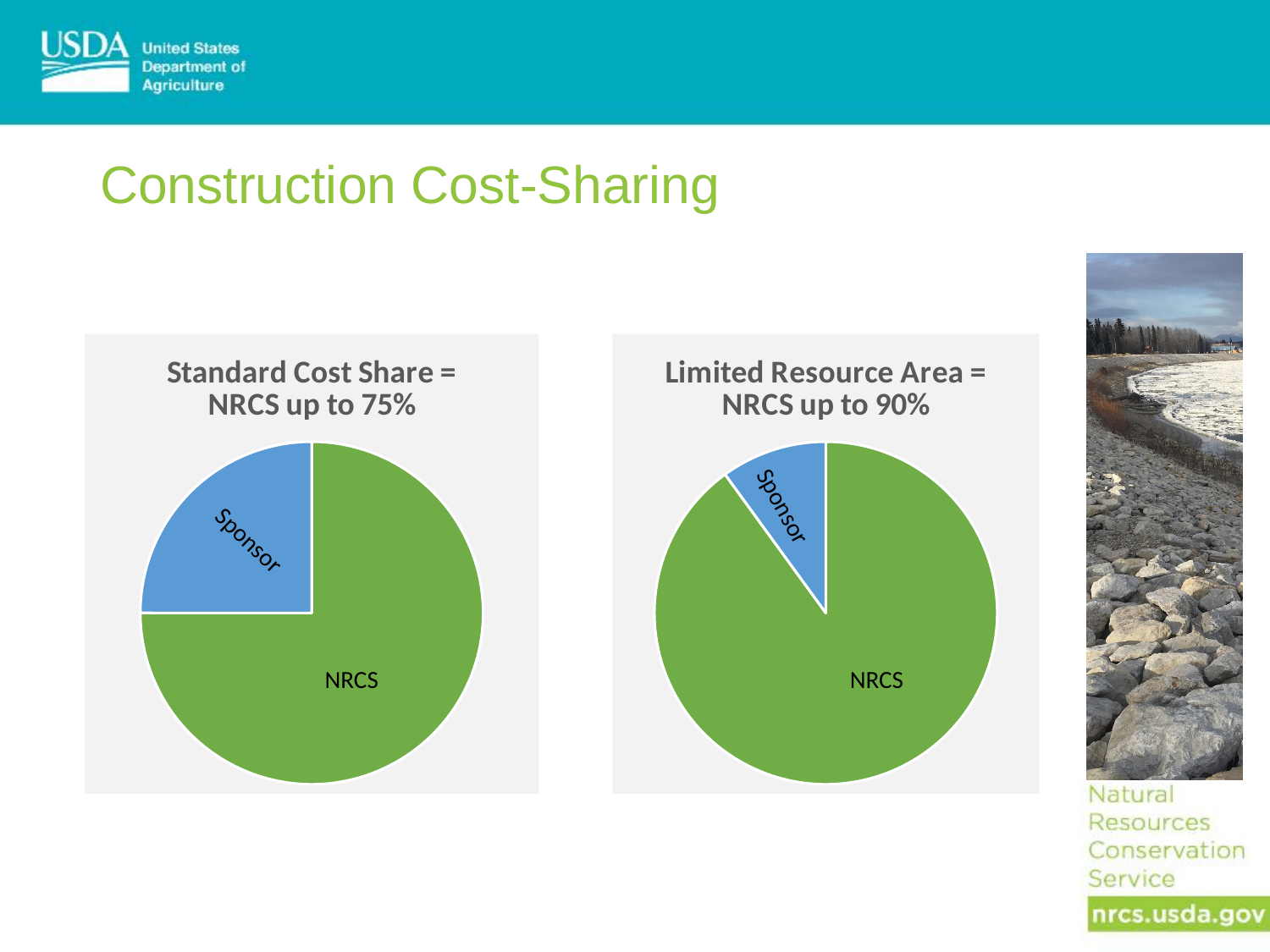
In the 'Standard Cost Share = NRCS up to 75%' chart, how many slices does the pie have? 2 In the 'Limited Resource Area = NRCS up to 90%' chart, how many slices does the pie have? 2 What kind of chart is the 'Standard Cost Share = NRCS up to 75%' chart? Pie chart In the 'Limited Resource Area = NRCS up to 90%' chart, what colour is the Sponsor slice? Blue What kind of chart is the 'Limited Resource Area = NRCS up to 90%' chart? Pie chart In the 'Limited Resource Area = NRCS up to 90%' chart, which slice is larger, NRCS or Sponsor? NRCS Comparing the two pie charts, in which chart is the Sponsor slice smaller? Limited Resource Area = NRCS up to 90% In the 'Standard Cost Share = NRCS up to 75%' chart, which slice is the largest? NRCS In the 'Standard Cost Share = NRCS up to 75%' chart, which slice is the smallest? Sponsor In the 'Limited Resource Area = NRCS up to 90%' chart, which slice is the largest? NRCS In the 'Limited Resource Area = NRCS up to 90%' chart, which slice is the smallest? Sponsor What is the title of the left pie chart? Standard Cost Share = NRCS up to 75%